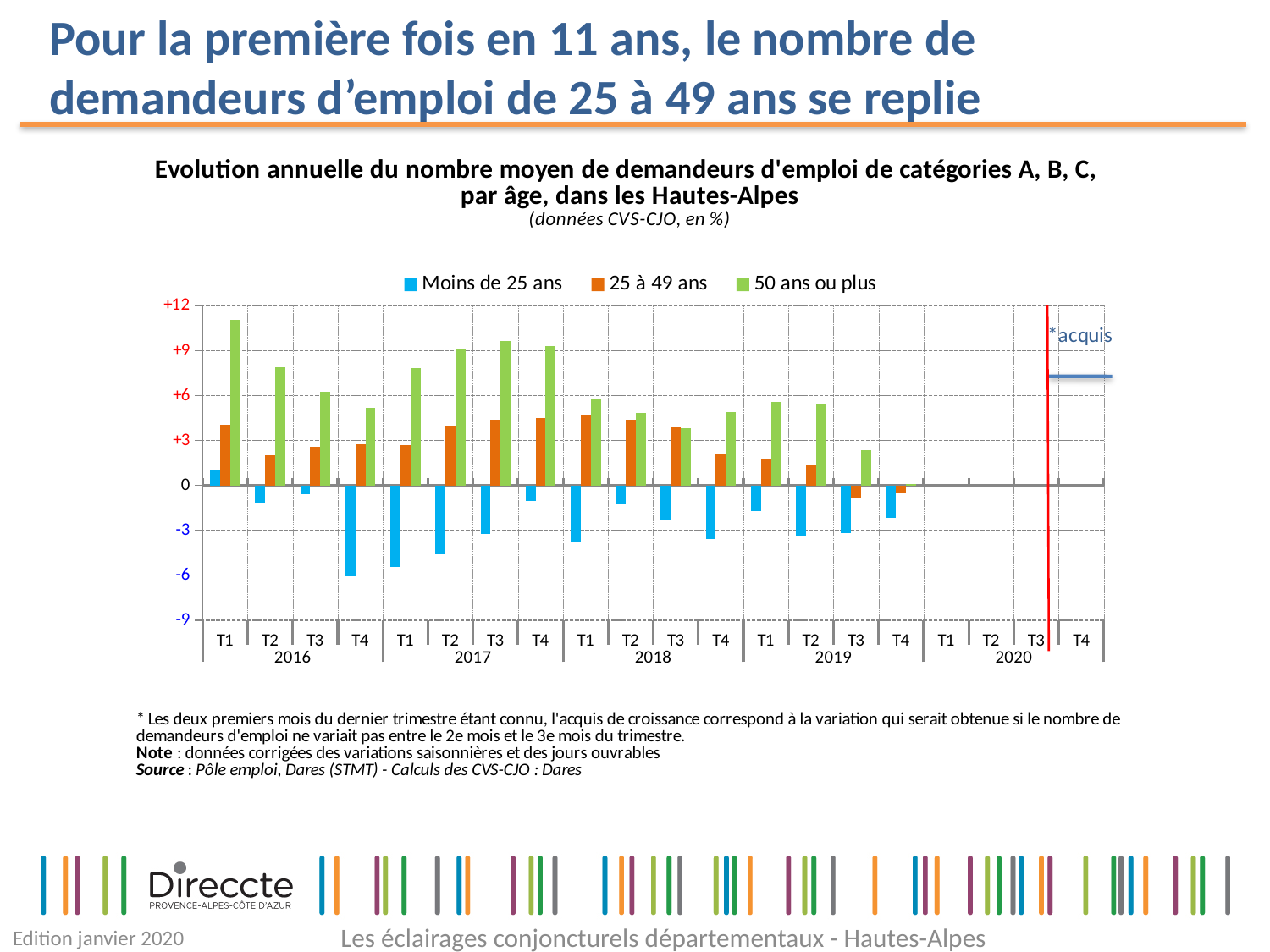
Is the value for 25 à 49 ans in T1 2018 greater or less than +3? greater What kind of chart is shown on the slide? bar chart How many years are labelled along the x axis? 5 In which quarter is the value for 50 ans ou plus the highest? T1 2016 Do the values for 25 à 49 ans rise or fall from T1 2018 to T4 2019? fall In which quarter is the value for Moins de 25 ans the lowest? T4 2016 How many series does the legend list? 3 Is the value for 25 à 49 ans in T3 2019 greater or less than 0? less Is the value for Moins de 25 ans in T4 2016 greater or less than -3? less What are the three series named in the legend? Moins de 25 ans, 25 à 49 ans, 50 ans ou plus In T1 2016, which is larger: the value for 50 ans ou plus or the value for 25 à 49 ans? 50 ans ou plus